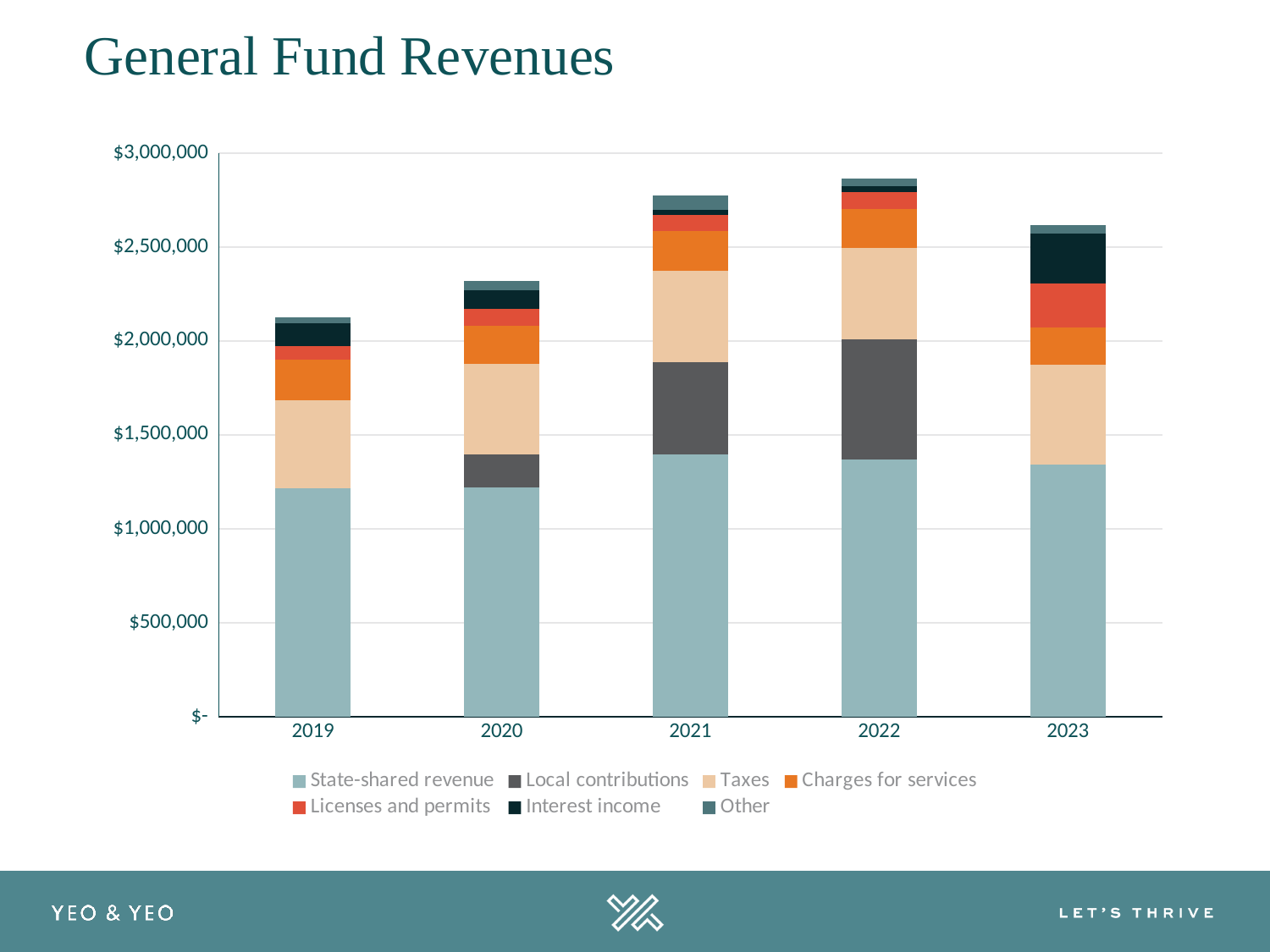
How many years are shown on the x axis of the chart? 5 Do total General Fund Revenues rise or fall from 2019 to 2022? rise Is the total revenue for 2021 greater or less than $2,500,000? greater Which year has the highest total General Fund Revenues? 2022 What is the title of the chart on the slide? General Fund Revenues Which year has the larger total revenue, 2020 or 2021? 2021 How many series does the legend list? 7 Which year has the lowest total General Fund Revenues? 2019 What kind of chart is shown on the slide? Stacked bar chart Is the total revenue for 2019 greater or less than $2,000,000? greater Is the State-shared revenue for 2019 greater or less than $1,000,000? greater